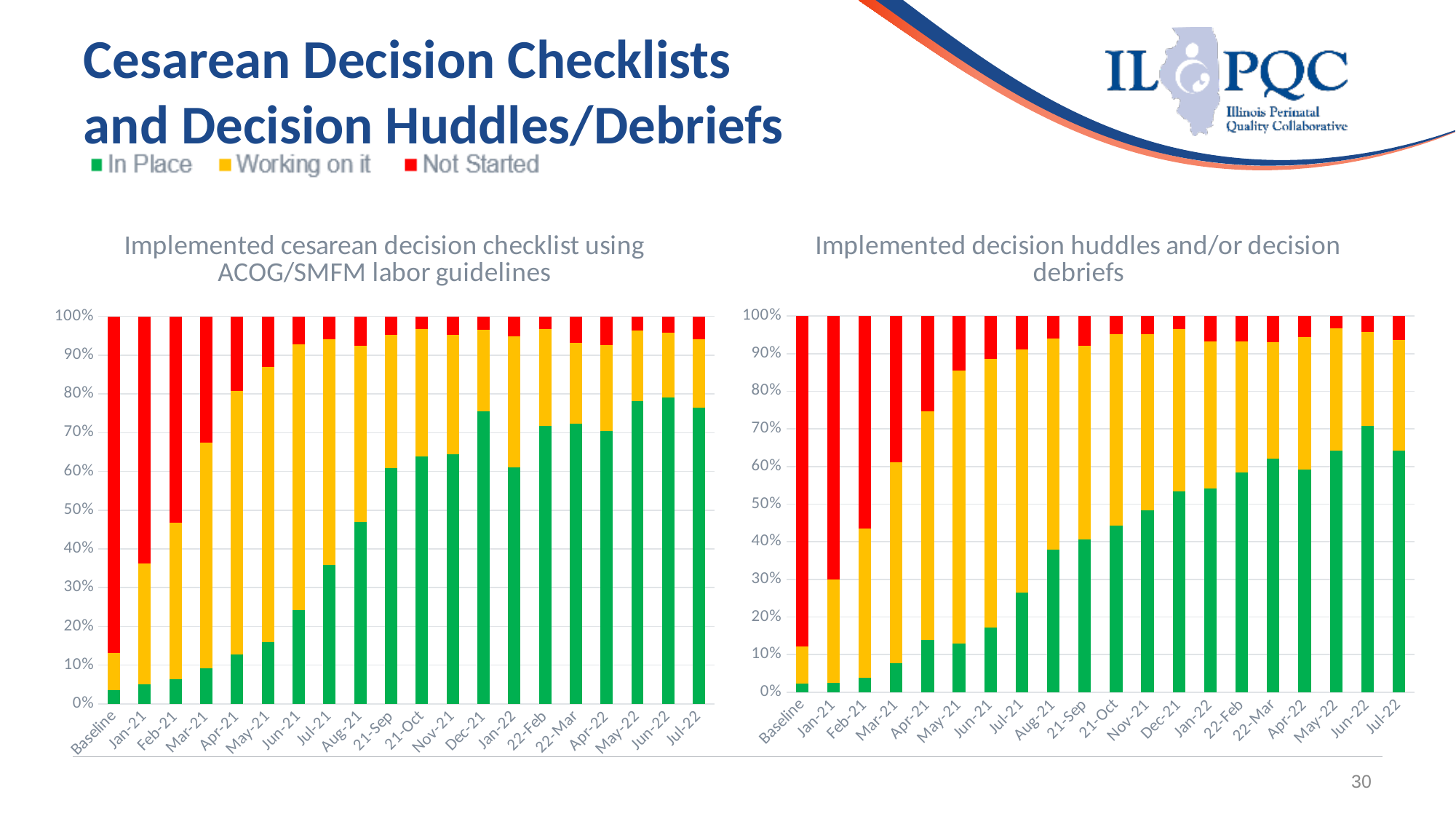
How many series does the legend list for the charts on this slide? 3 In the left chart, 'Implemented cesarean decision checklist', what is the total of each stacked bar? 100% In the left chart, 'Implemented cesarean decision checklist', is the 'In Place' value for Dec-21 greater or less than 70%? greater In the right chart, 'Implemented decision huddles and/or decision debriefs', does the 'In Place' share generally rise or fall from Baseline to Jul-22? Rise In the left chart, 'Implemented cesarean decision checklist', is the 'In Place' value for Baseline greater or less than 10%? less How many time-period categories are shown on the x axis of the right chart, 'Implemented decision huddles and/or decision debriefs'? 20 What kind of chart is the left chart, 'Implemented cesarean decision checklist using ACOG/SMFM labor guidelines'? Stacked bar chart In the left chart, 'Implemented cesarean decision checklist', which is larger, the 'In Place' share for Jun-21 or for Jul-21? Jul-21 In the right chart, 'Implemented decision huddles and/or decision debriefs', which category has the largest 'In Place' share? Jun-22 In the right chart, 'Implemented decision huddles and/or decision debriefs', is the 'In Place' value for Jul-22 greater or less than 60%? greater In the right chart, 'Implemented decision huddles and/or decision debriefs', which category has the largest 'Not Started' share? Baseline Which colour represents 'Not Started' in the legend? Red